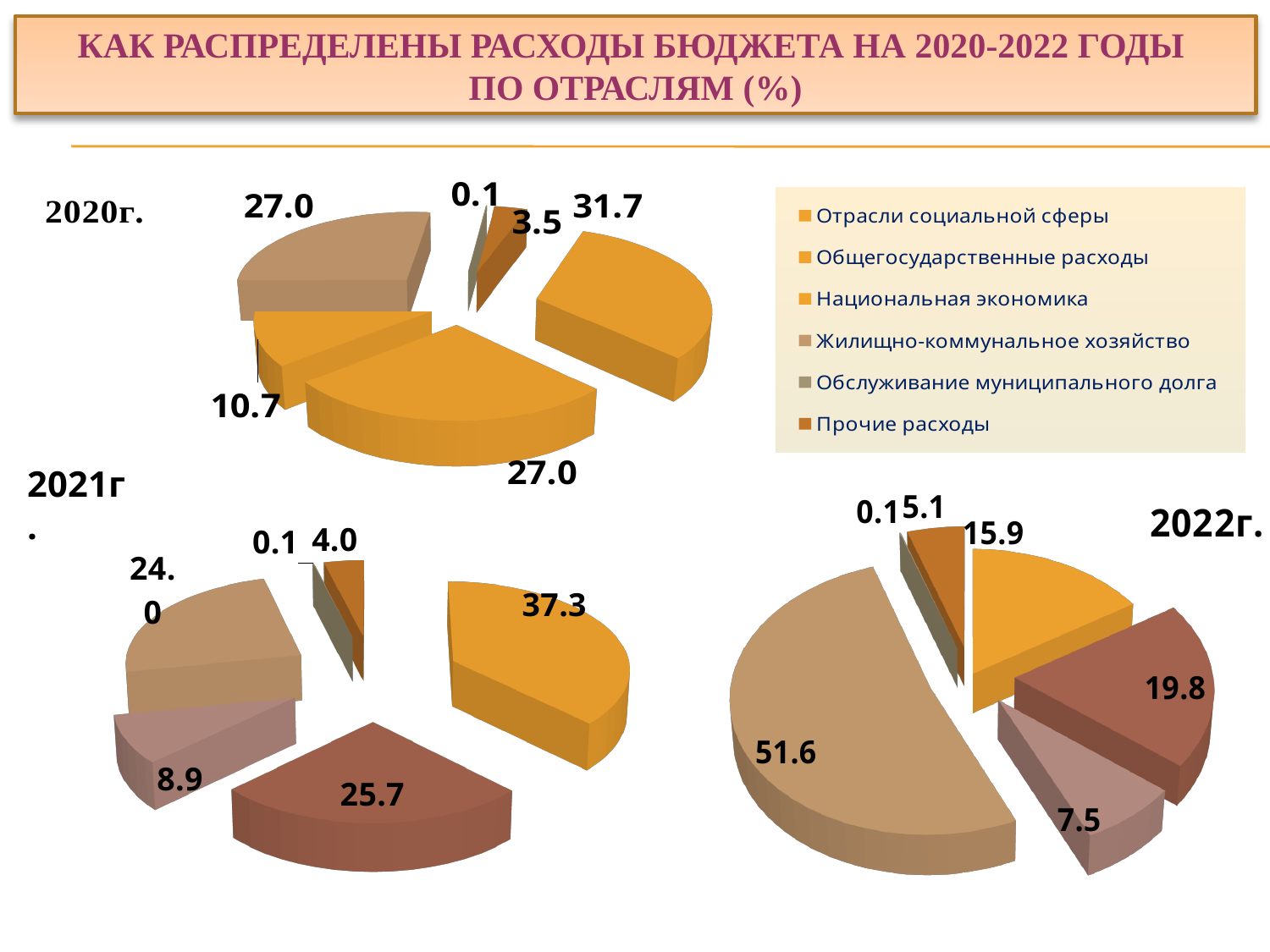
How many entries does the legend list? 6 How many slices does the 2022г. pie chart have? 6 In the 2021г. chart, what is the value for Прочие расходы? 4.0 What is the title of the slide? КАК РАСПРЕДЕЛЕНЫ РАСХОДЫ БЮДЖЕТА НА 2020-2022 ГОДЫ ПО ОТРАСЛЯМ (%) In the 2022г. chart, what is the difference between the slices labelled 19.8 and 7.5? 12.3 In the 2022г. chart, what is the value of the largest slice? 51.6 In the 2021г. chart, what is the difference between the slices labelled 37.3 and 25.7? 11.6 In the 2022г. chart, what is the value for Обслуживание муниципального долга? 0.1 In the 2020г. chart, which is larger: the slice labelled 31.7 or the slice labelled 10.7? 31.7 In the 2021г. chart, what is the value of the largest slice? 37.3 In the 2020г. chart, what is the value of the smallest slice? 0.1 What kind of chart is the 2020г. chart? pie chart